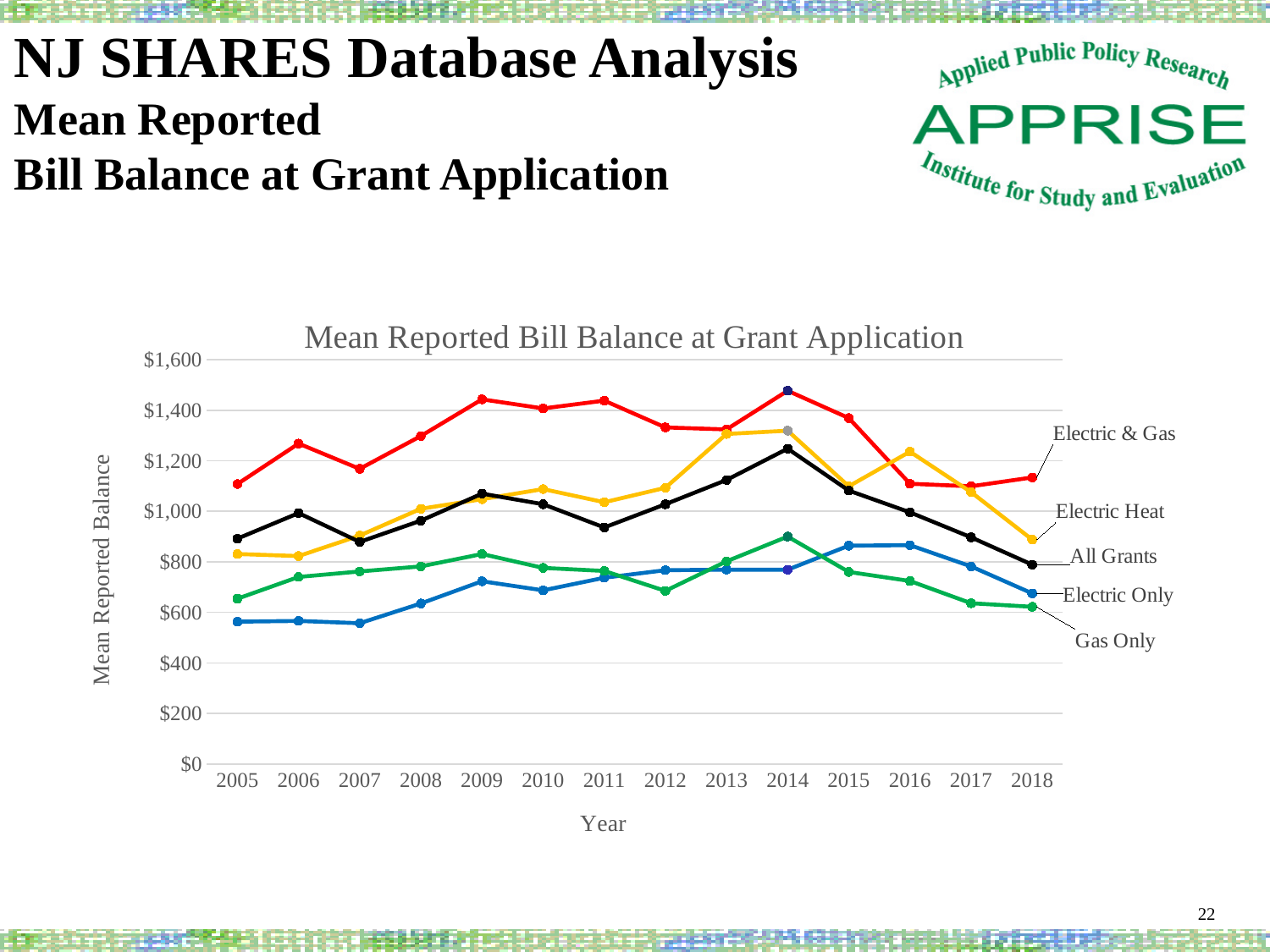
What is the label on the y axis of the chart? Mean Reported Balance In which year does the Electric & Gas series reach its highest value? 2014 How many series are plotted in the chart? 5 Is the All Grants value for 2014 greater or less than $1,200? greater What kind of chart is shown on the slide? line chart In which year does the Gas Only series reach its highest value? 2014 In which year is the All Grants series at its lowest value? 2018 Does the Electric & Gas series rise or fall from 2014 to 2018? fall In 2016, which series has the higher value: Electric Heat or All Grants? Electric Heat Is the Gas Only value for 2005 greater or less than $800? less Is the Electric & Gas value for 2014 greater or less than $1,400? greater How many years are shown on the x axis of the chart? 14